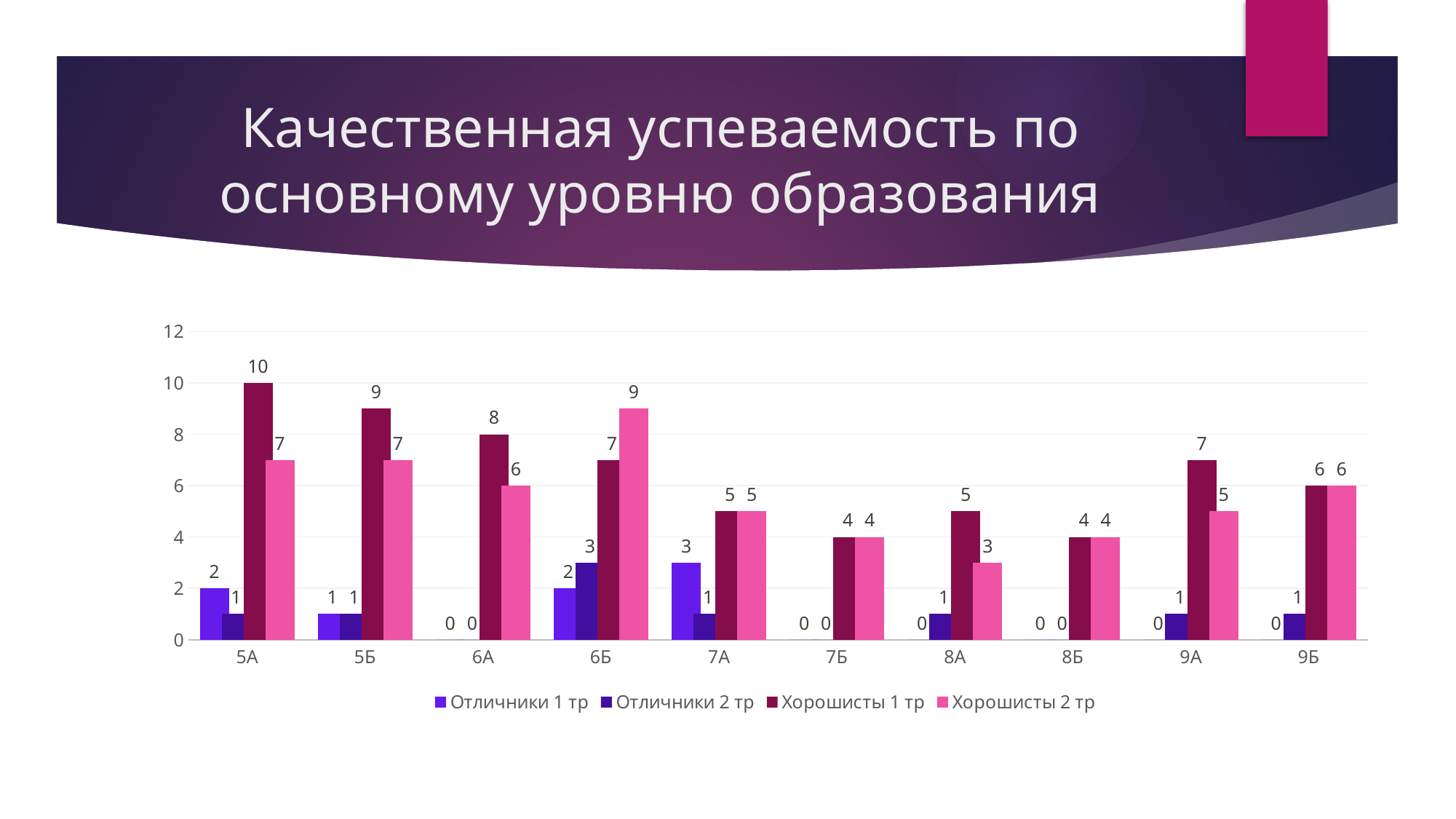
Which class has the highest value for Хорошисты 1 тр? 5А Which class has the highest value for Отличники 2 тр? 6Б What is the difference between Хорошисты 1 тр and Хорошисты 2 тр for 6А? 2 What is the value of Отличники 2 тр for 9А? 1 What is the value of Хорошисты 1 тр for 5А? 10 Which is larger for 8А: Хорошисты 1 тр or Хорошисты 2 тр? Хорошисты 1 тр How many classes are shown on the x axis? 10 How many series does the legend list? 4 What kind of chart is shown on the slide? Bar chart What is the value of Отличники 1 тр for 7А? 3 What is the value of Хорошисты 2 тр for 6Б? 9 What is the title of the slide? Качественная успеваемость по основному уровню образования